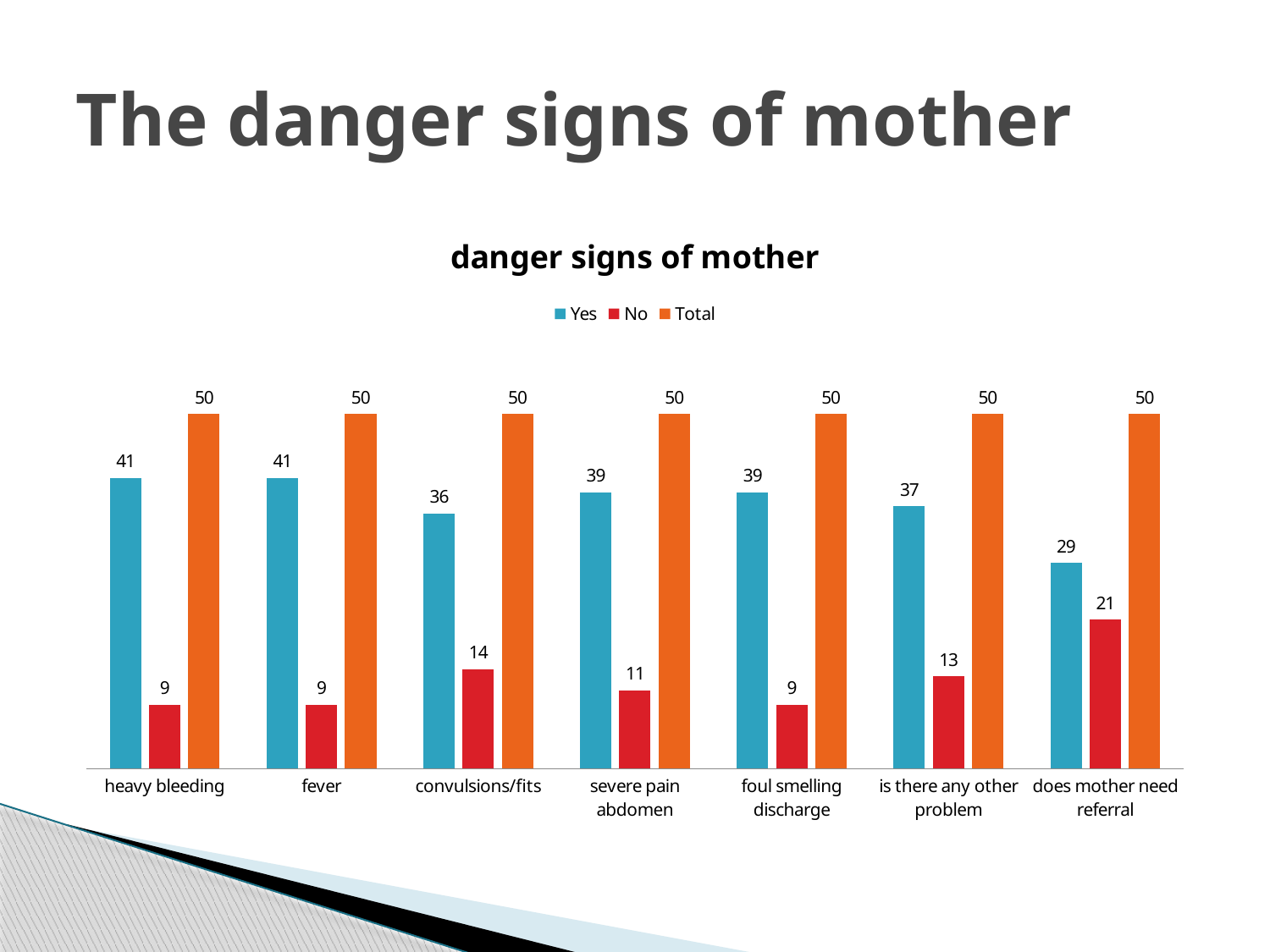
What kind of chart is shown on the slide? bar chart What is the No value for does mother need referral? 21 Which is larger, the Yes value for convulsions/fits or the Yes value for is there any other problem? is there any other problem What is the title of the chart? danger signs of mother What is the Total value for fever? 50 Which category has the lowest Yes value? does mother need referral How many series does the legend list? 3 What is the Yes value for heavy bleeding? 41 What is the difference between the Yes and No values for severe pain abdomen? 28 How many categories are shown on the x axis? 7 What is the No value for convulsions/fits? 14 Which category has the highest No value? does mother need referral